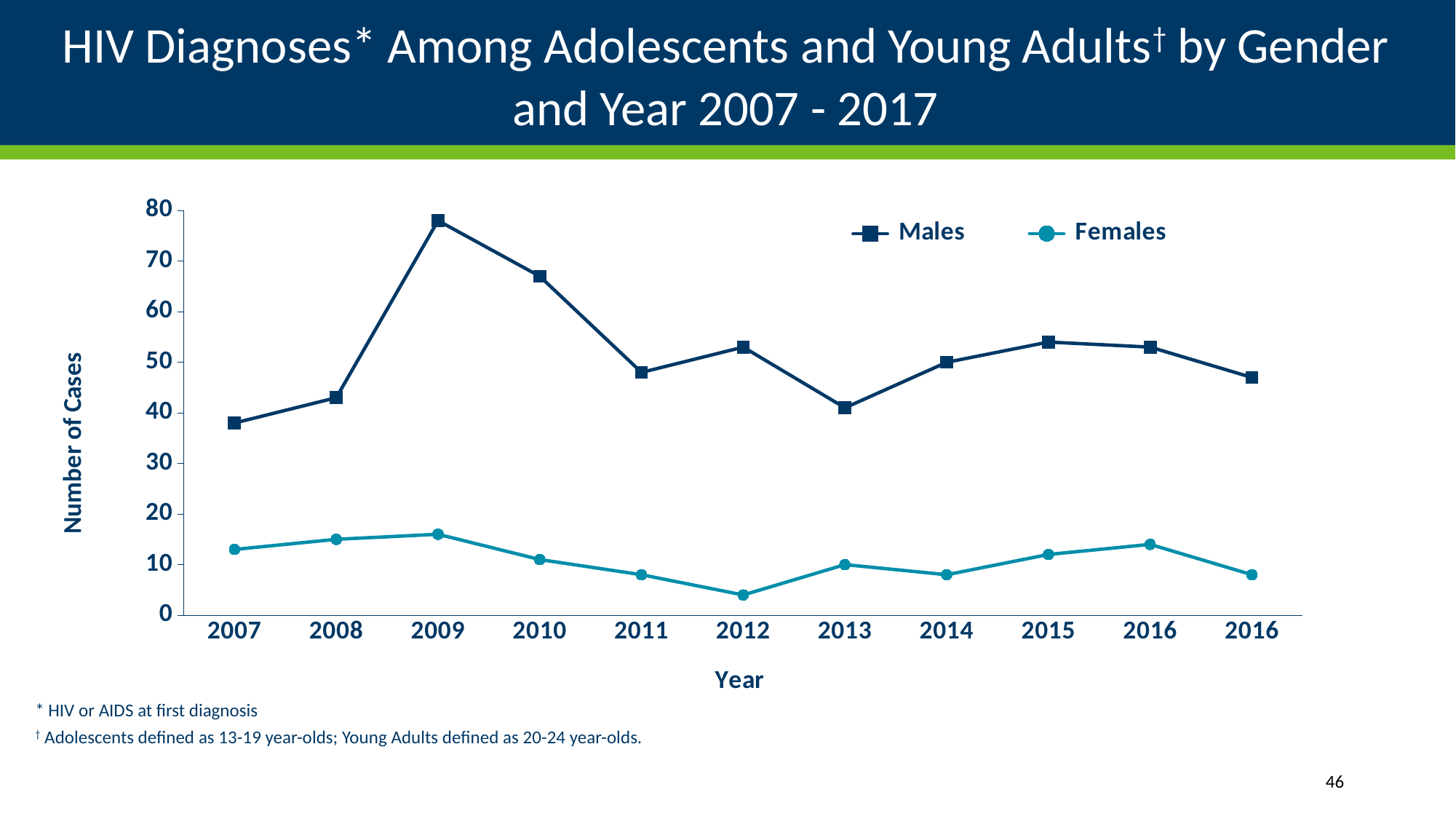
Is the value for Males in 2010 greater or less than 60? greater Is the value for Males in 2009 greater or less than 70? greater Do the Males values rise or fall from 2009 to 2011? fall Is the value for Females in 2012 greater or less than 10? less What kind of chart is shown on the slide? line chart Which is larger, the Males value in 2009 or the Males value in 2010? 2009 In which year is the number of cases for Males highest? 2009 In which year is the number of cases for Males lowest? 2007 How many years are plotted along the x axis? 11 What is the label on the y axis? Number of Cases How many series does the legend list? 2 In which year is the number of cases for Females lowest? 2012